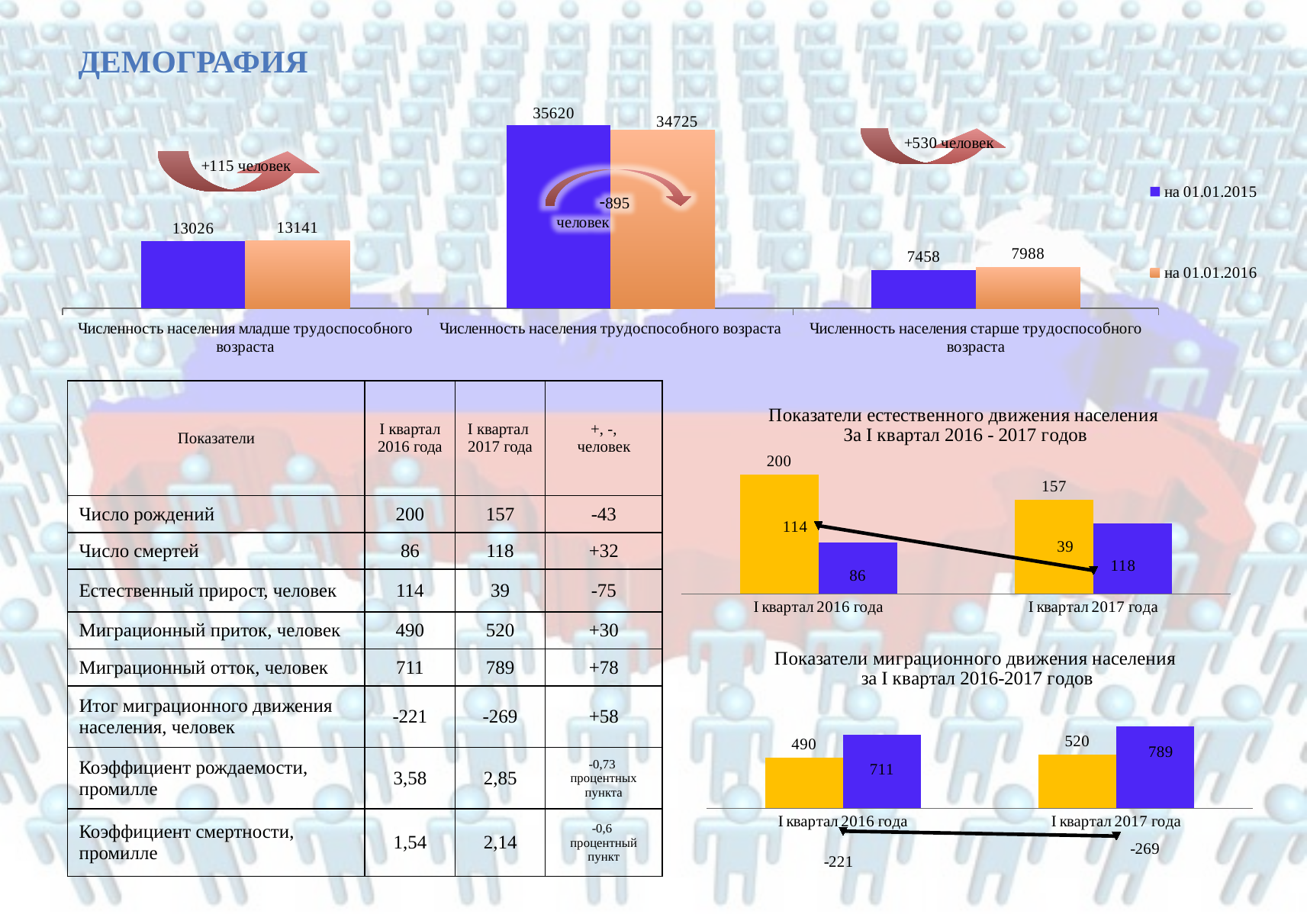
In the top population chart, what is the difference between the 01.01.2016 and 01.01.2015 values for Численность населения младше трудоспособного возраста? 115 In the chart 'Показатели миграционного движения населения', what is the value of the blue bar for I квартал 2017 года? 789 In the chart 'Показатели естественного движения населения', what is the difference between the yellow bar values for I квартал 2016 года and I квартал 2017 года? 43 In the top population chart, which is larger for Численность населения старше трудоспособного возраста: the value на 01.01.2015 or на 01.01.2016? на 01.01.2016 In the top population chart, which category has the highest values? Численность населения трудоспособного возраста In the chart 'Показатели естественного движения населения', which quarter has the larger blue bar? I квартал 2017 года In the top population chart, what is the value for Численность населения трудоспособного возраста на 01.01.2015? 35620 What kind of chart is the top population chart? bar chart In the top population chart, what is the value for Численность населения старше трудоспособного возраста на 01.01.2016? 7988 In the chart 'Показатели естественного движения населения', what is the value of the yellow bar for I квартал 2017 года? 157 In the top population chart, how many series does the legend list? 2 In the chart 'Показатели миграционного движения населения', do the yellow bar values rise or fall from I квартал 2016 года to I квартал 2017 года? rise